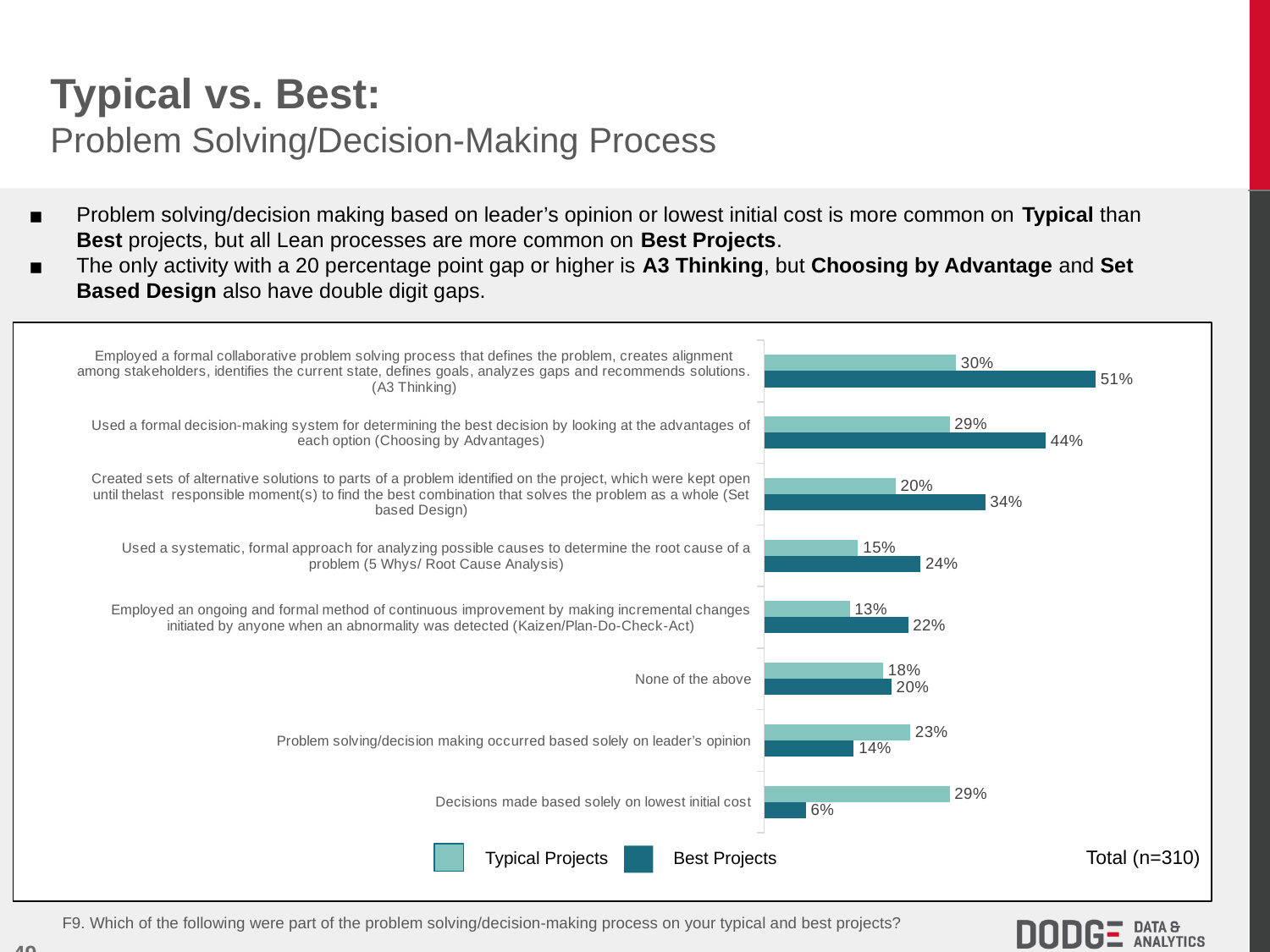
What is the value for Typical Projects for Choosing by Advantages? 29% What is the difference between Typical Projects and Best Projects for Set based Design? 14 percentage points What is the value for Best Projects for 'Decisions made based solely on lowest initial cost'? 6% What kind of chart is shown on the slide? bar chart Which category has the lowest Best Projects value? Decisions made based solely on lowest initial cost Which category has the highest Best Projects value? A3 Thinking What sample size is shown in the chart? Total (n=310) What is the difference between Best Projects and Typical Projects for A3 Thinking? 21 percentage points What is the value for Best Projects for A3 Thinking? 51% For 'Problem solving/decision making occurred based solely on leader's opinion', which is larger: Typical Projects or Best Projects? Typical Projects How many series does the legend list? 2 How many categories are plotted in the chart? 8